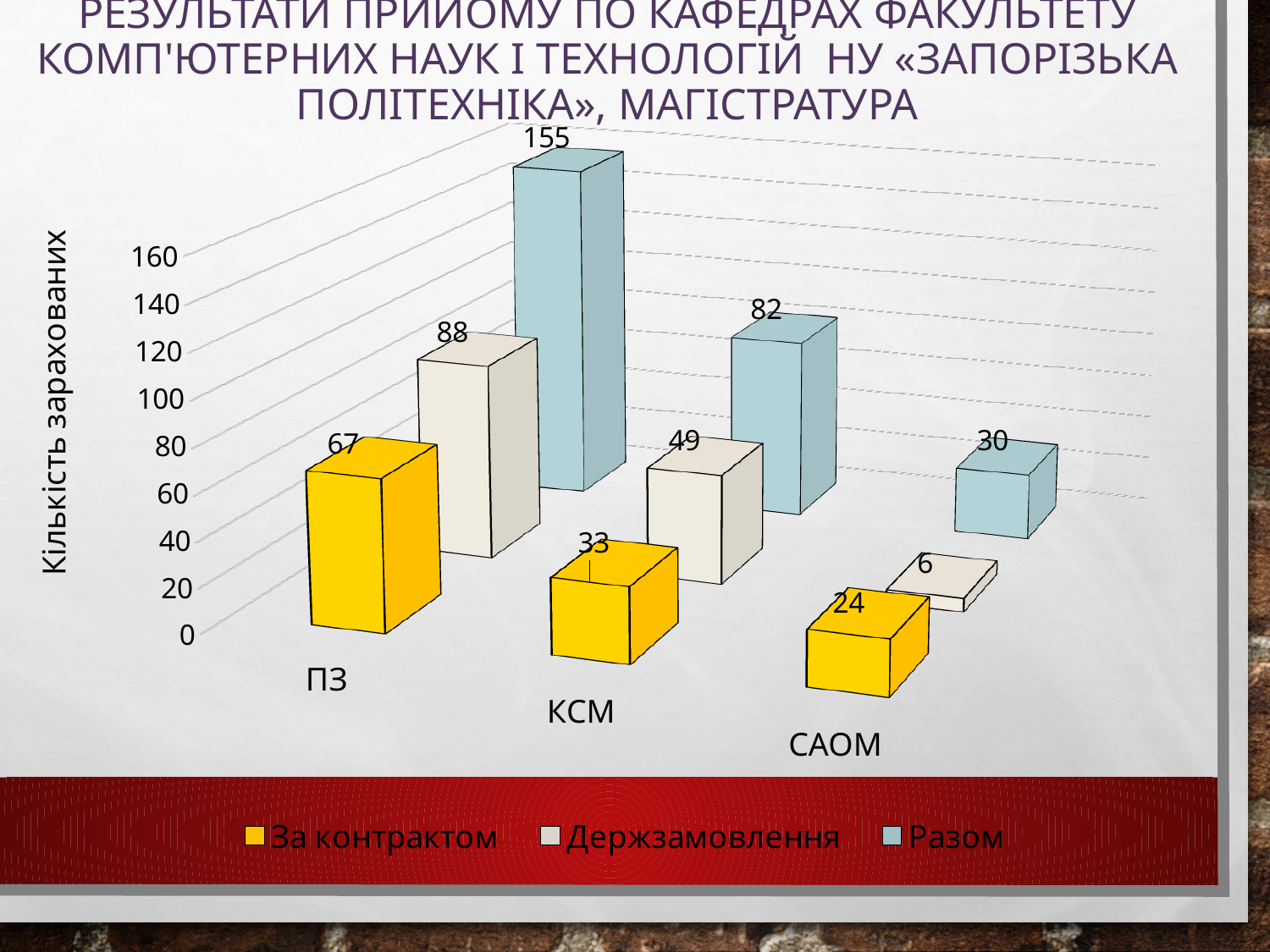
Which category has the lowest За контрактом value? САОМ What is the value of Держзамовлення for ПЗ? 88 What is the difference between the Разом values for ПЗ and КСМ? 73 What is the label of the vertical axis? Кількість зарахованих What is the value of За контрактом for КСМ? 33 How many categories are shown on the x axis? 3 How many series does the legend list? 3 What kind of chart is shown on the slide? Bar chart What is the value of Разом for ПЗ? 155 Which is larger for КСМ: За контрактом or Держзамовлення? Держзамовлення Which category has the highest Разом value? ПЗ What is the value of Держзамовлення for САОМ? 6